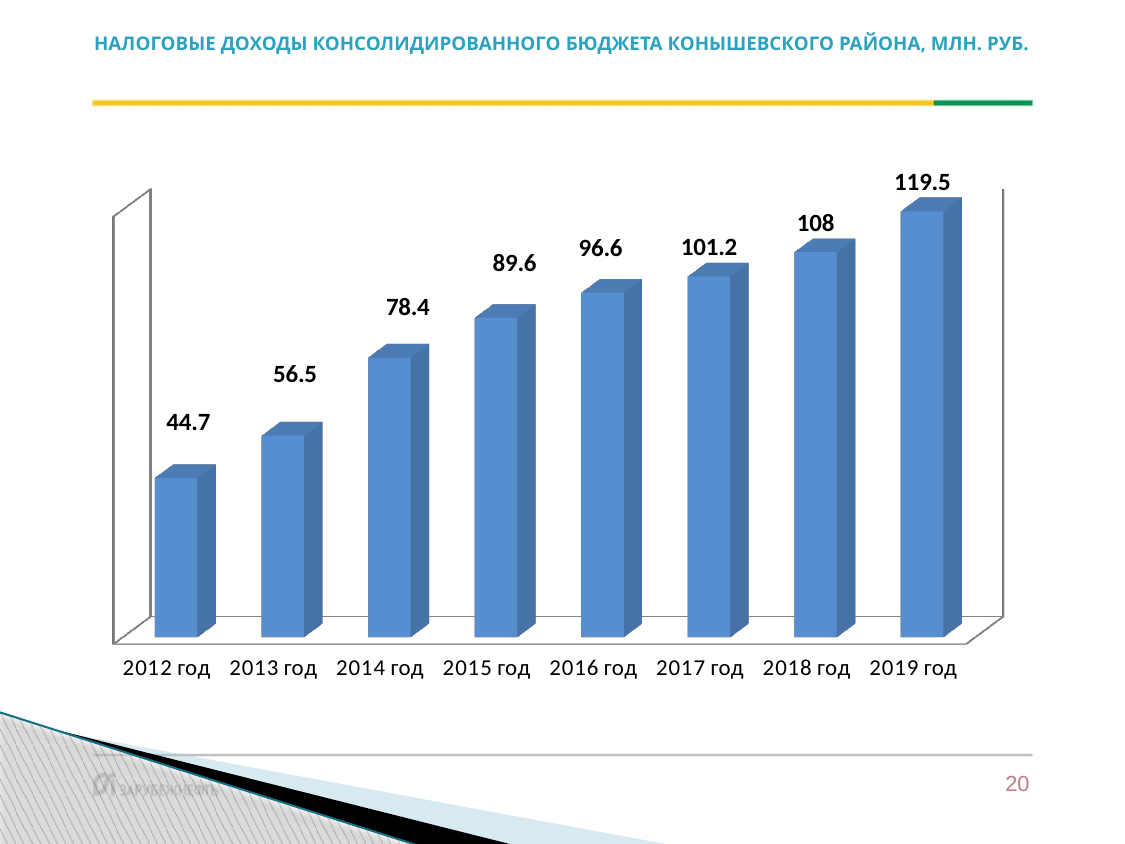
How many years are shown on the chart? 8 Do the values rise or fall from 2012 год to 2019 год? rise Which is larger, the value for 2016 год or the value for 2017 год? 2017 год What is the value for 2018 год? 108 What is the value for 2012 год? 44.7 What kind of chart is shown on the slide? bar chart What is the difference between the values for 2014 год and 2013 год? 21.9 Which year has the highest value? 2019 год What is the value for 2015 год? 89.6 Which year has the lowest value? 2012 год What is the title of the chart? НАЛОГОВЫЕ ДОХОДЫ КОНСОЛИДИРОВАННОГО БЮДЖЕТА КОНЫШЕВСКОГО РАЙОНА, МЛН. РУБ. What is the difference between the values for 2019 год and 2012 год? 74.8